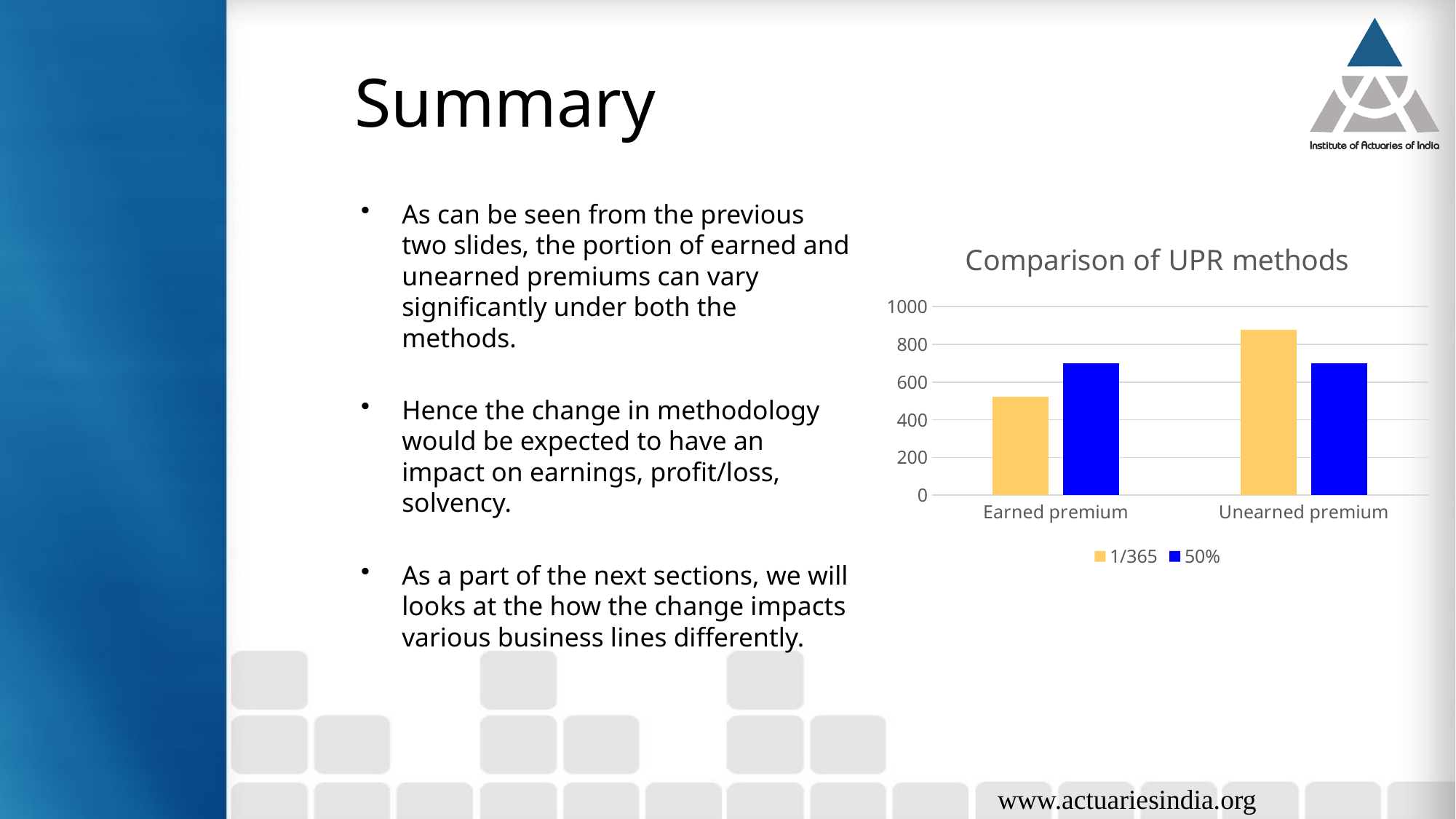
What type of chart is shown on the slide? Bar chart Is the value for 1/365 under Earned premium greater or less than 400? greater How many categories are shown on the x axis of the chart? 2 Which category has the highest value for the 1/365 series? Unearned premium Which series is shown in blue in the chart? 50% What is the title of the chart? Comparison of UPR methods Is the value for 50% under Unearned premium greater or less than 800? less How many series does the chart legend list? 2 Is the value for 1/365 under Unearned premium greater or less than 800? greater For Earned premium, which series has the larger value, 1/365 or 50%? 50% For Unearned premium, which series has the larger value, 1/365 or 50%? 1/365